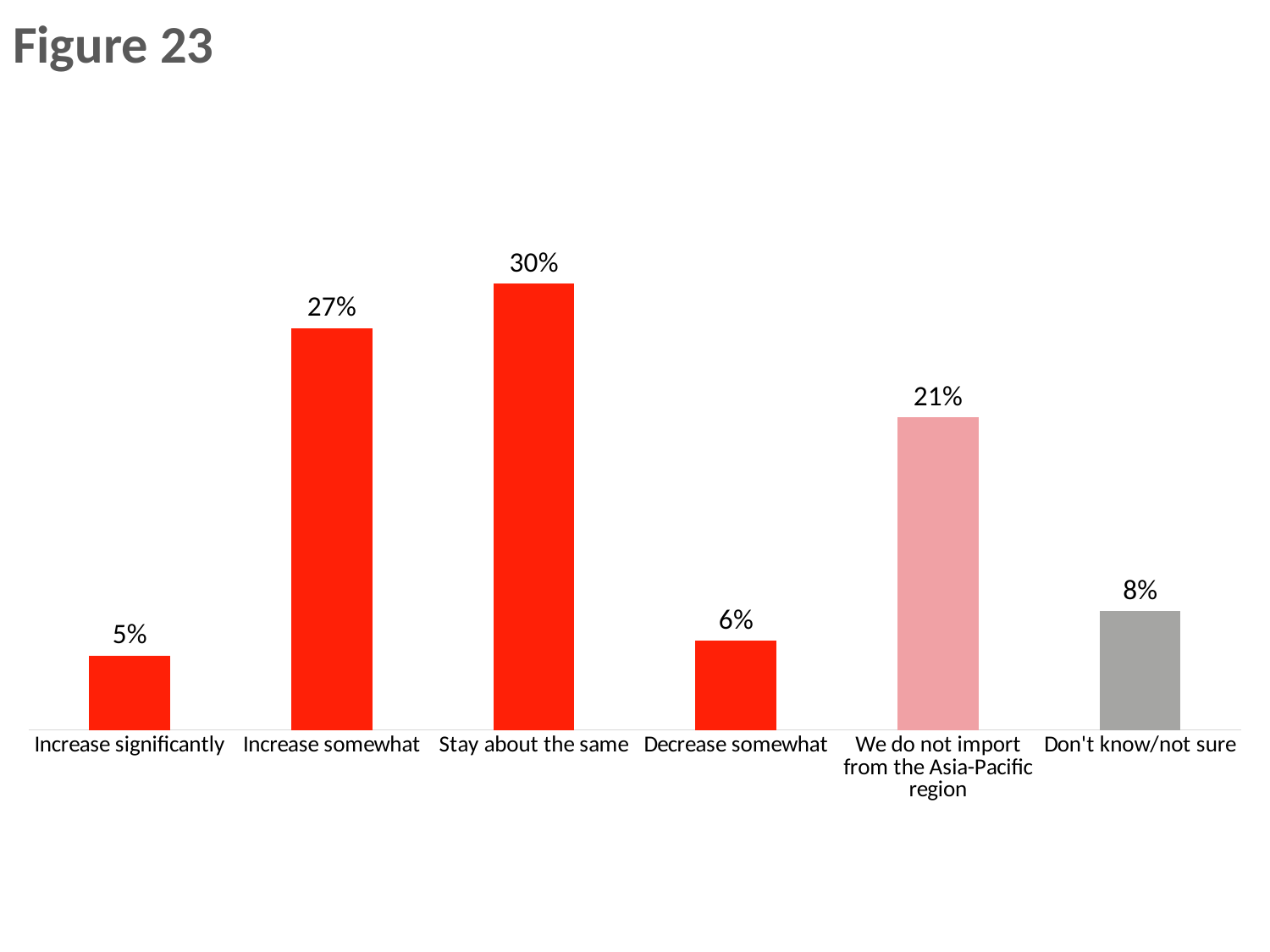
What is the title shown at the top of the slide? Figure 23 Which category has the highest value? Stay about the same What is the value for "We do not import from the Asia-Pacific region"? 21% What is the value for "Stay about the same"? 30% How many categories are shown in the chart? 6 What is the value for "Don't know/not sure"? 8% What kind of chart is shown on the slide? Bar chart What is the value for "Increase significantly"? 5% Which category has the lowest value? Increase significantly Which is larger, "Increase somewhat" or "Decrease somewhat"? Increase somewhat What is the difference between "We do not import from the Asia-Pacific region" and "Don't know/not sure"? 13% What is the difference between "Stay about the same" and "Increase somewhat"? 3%